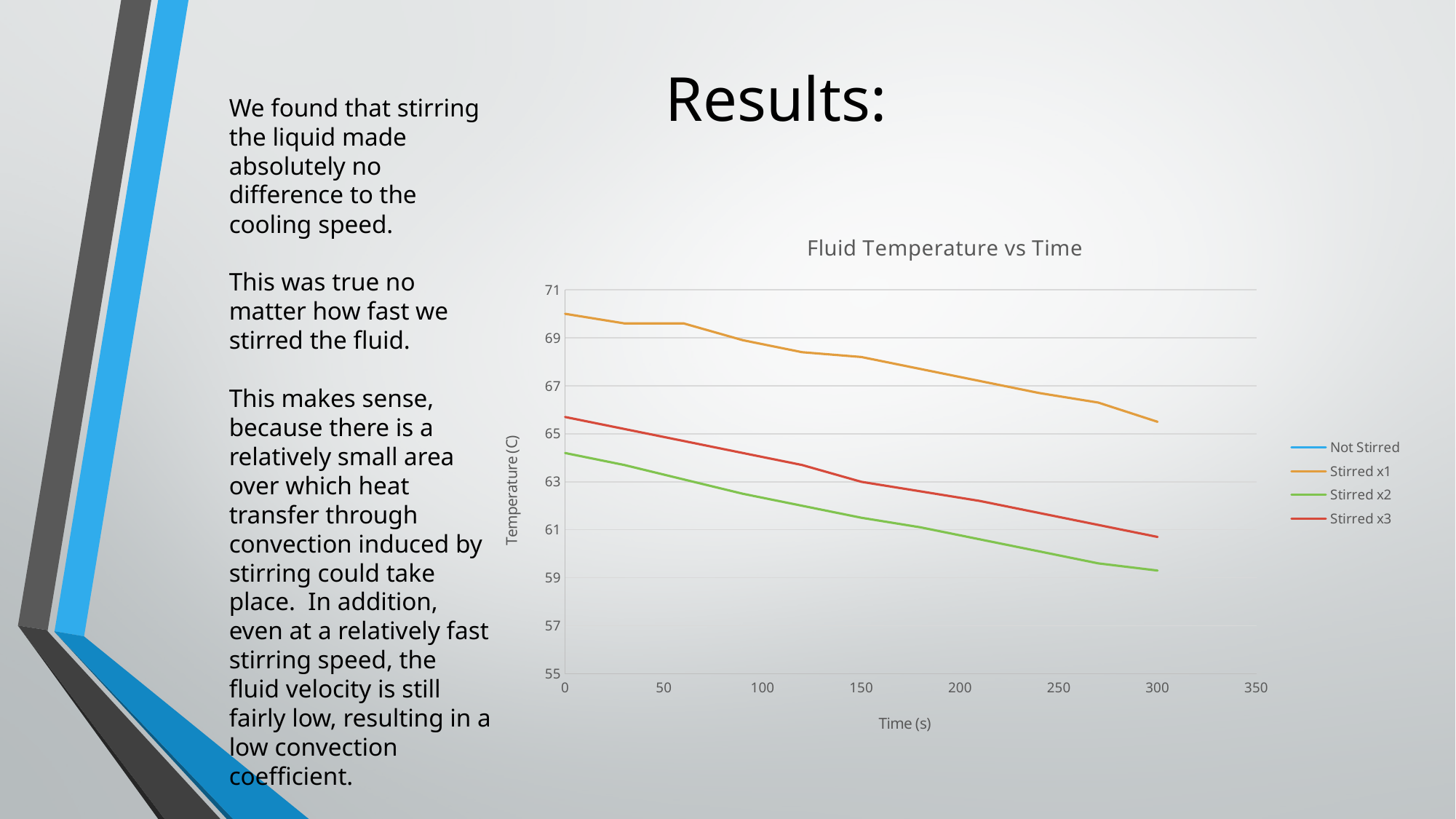
How many series does the chart's legend list? 4 Do the temperature values rise or fall as time increases along the x axis? fall Which series has the lowest temperature at 300 s? Stirred x2 Is the temperature for Stirred x1 at time 0 greater or less than 69? greater What is the title of the chart? Fluid Temperature vs Time What kind of chart is shown on the slide? line chart At time 0, which series has the higher temperature, Stirred x3 or Stirred x2? Stirred x3 Is the temperature for Stirred x1 at 300 s greater or less than 67? less Is the temperature for Stirred x2 at 300 s greater or less than 61? less What is the label of the chart's vertical axis? Temperature (C) Which series has the highest temperature at 300 s? Stirred x1